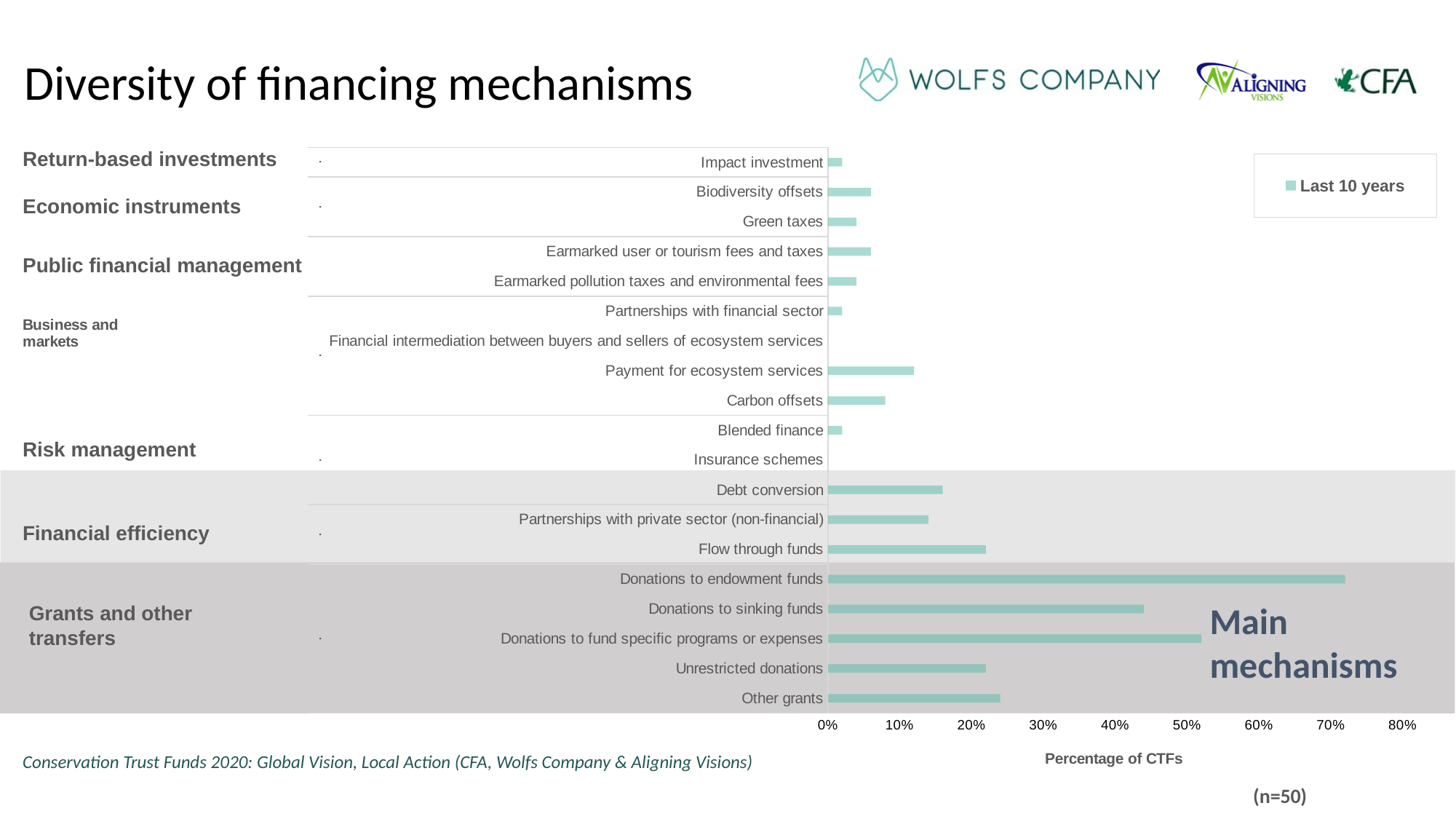
Which financing mechanism has the highest percentage of CTFs? Donations to endowment funds How many series does the legend list? 1 Which is larger: Payment for ecosystem services or Carbon offsets? Payment for ecosystem services Is the value for Other grants greater or less than 20%? greater Is the value for Payment for ecosystem services greater or less than 20%? less Is the value for Donations to endowment funds greater or less than 60%? greater What is the legend entry for the series shown? Last 10 years What kind of chart is shown on the slide? bar chart Which is larger: Donations to fund specific programs or expenses, or Donations to sinking funds? Donations to fund specific programs or expenses What is the title of the horizontal axis? Percentage of CTFs How many financing mechanisms are listed as categories on the chart? 19